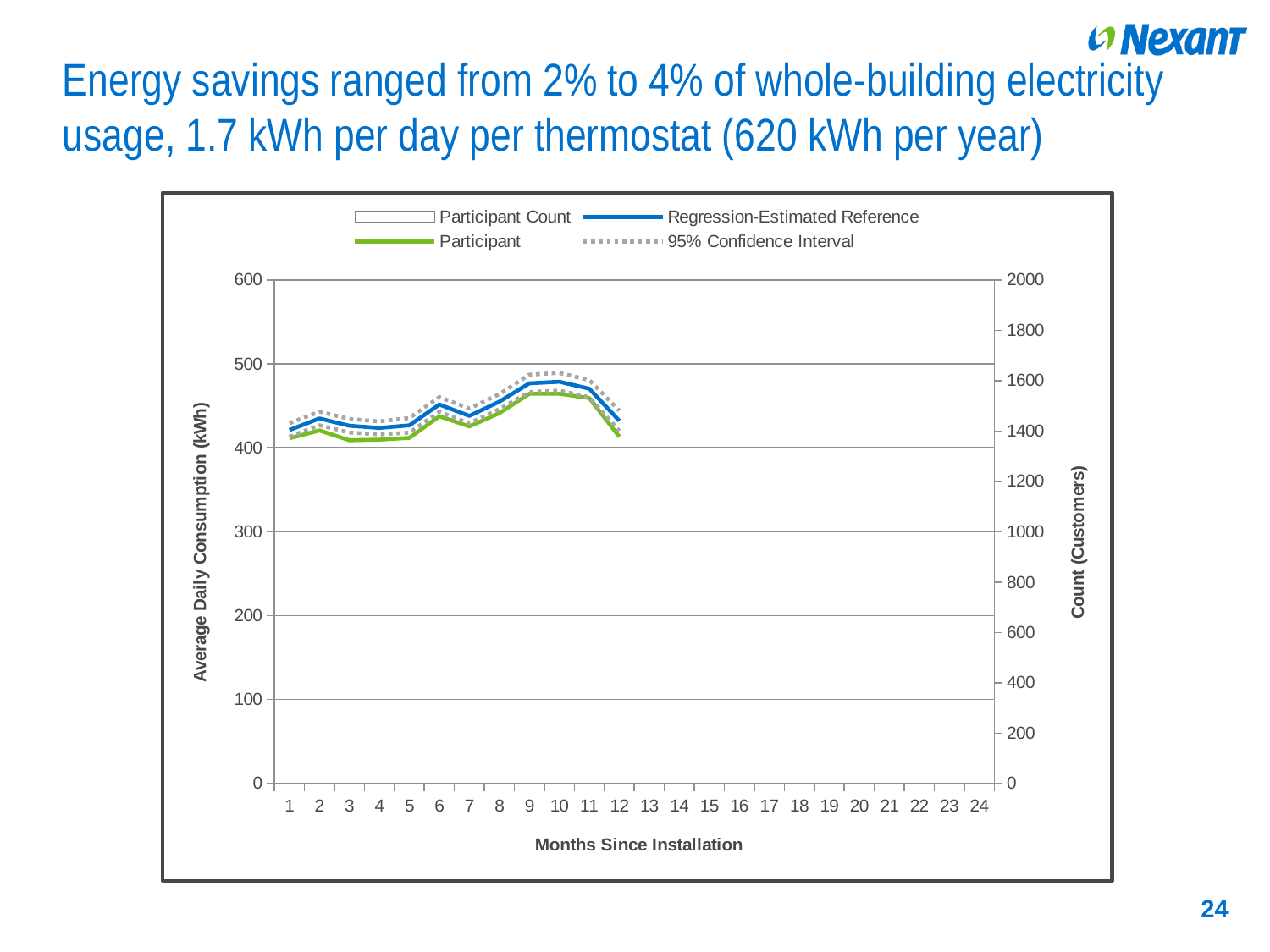
How many series does the chart's legend list? 4 Does the Participant line rise or fall from month 5 to month 9? rise What kind of chart is shown on the slide? line chart Does the Regression-Estimated Reference line rise or fall from month 10 to month 12? fall Is the Participant value at month 1 greater or less than 500? less Up to which month since installation are the Participant and Regression-Estimated Reference lines plotted? 12 Is the Participant value at month 3 greater or less than 300? greater At month 9, which is higher: the Regression-Estimated Reference line or the Participant line? Regression-Estimated Reference Is the Regression-Estimated Reference value at month 9 greater or less than 400? greater How many months are labelled on the x axis of the chart? 24 What is the title of the left vertical axis of the chart? Average Daily Consumption (kWh)